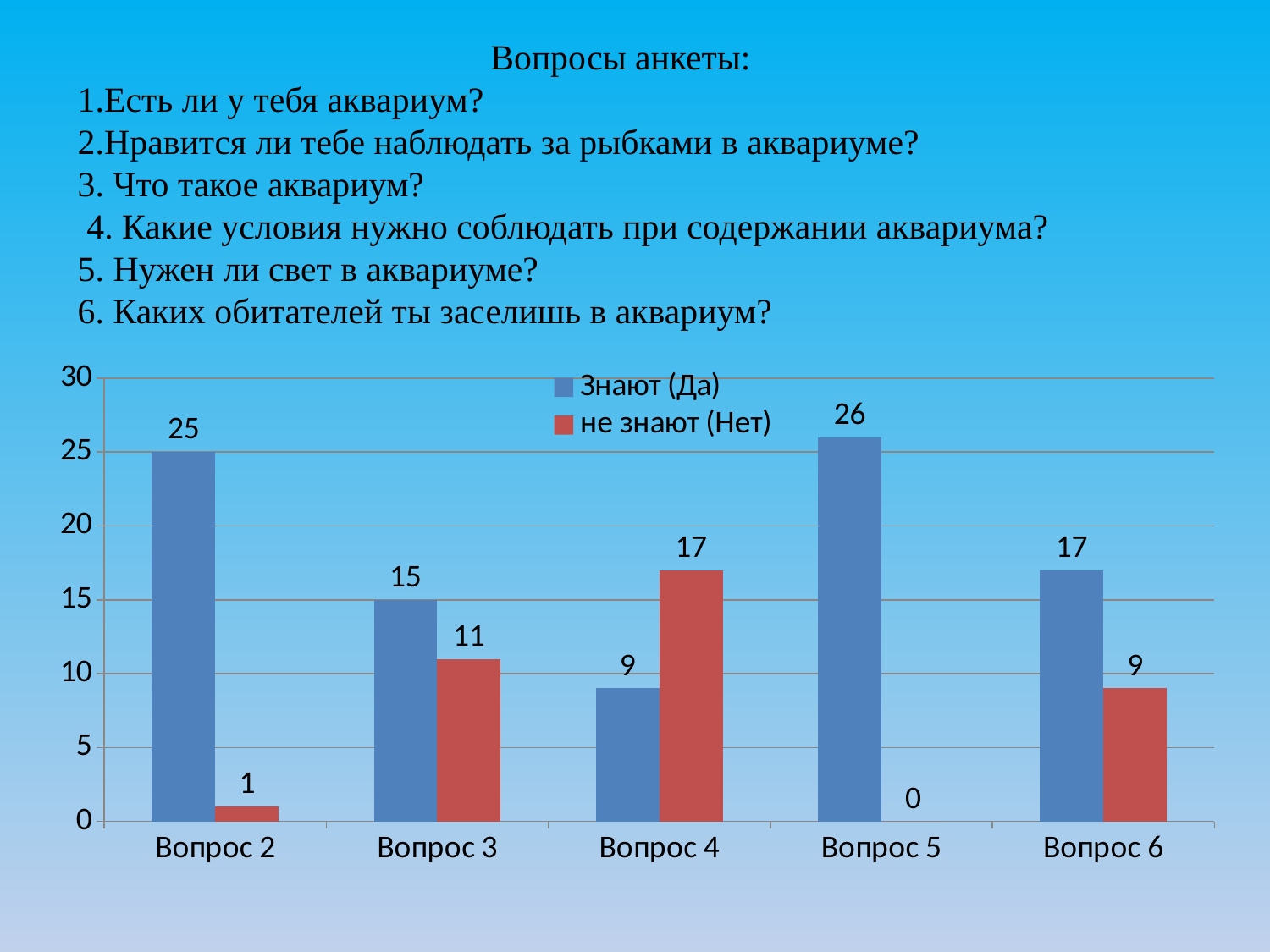
How many categories are shown on the x axis? 5 What is the value for "не знают (Нет)" for Вопрос 4? 17 Which category has the lowest value for "Знают (Да)"? Вопрос 4 What is the difference between "Знают (Да)" and "не знают (Нет)" for Вопрос 3? 4 What is the value for "Знают (Да)" for Вопрос 2? 25 For Вопрос 4, which is larger: "Знают (Да)" or "не знают (Нет)"? не знают (Нет) Is the value for "Знают (Да)" for Вопрос 6 greater or less than 20? less What is the value for "не знают (Нет)" for Вопрос 5? 0 Which category has the highest value for "Знают (Да)"? Вопрос 5 What colour are the bars for the "не знают (Нет)" series? red How many series does the legend list? 2 What kind of chart is shown on the slide? bar chart